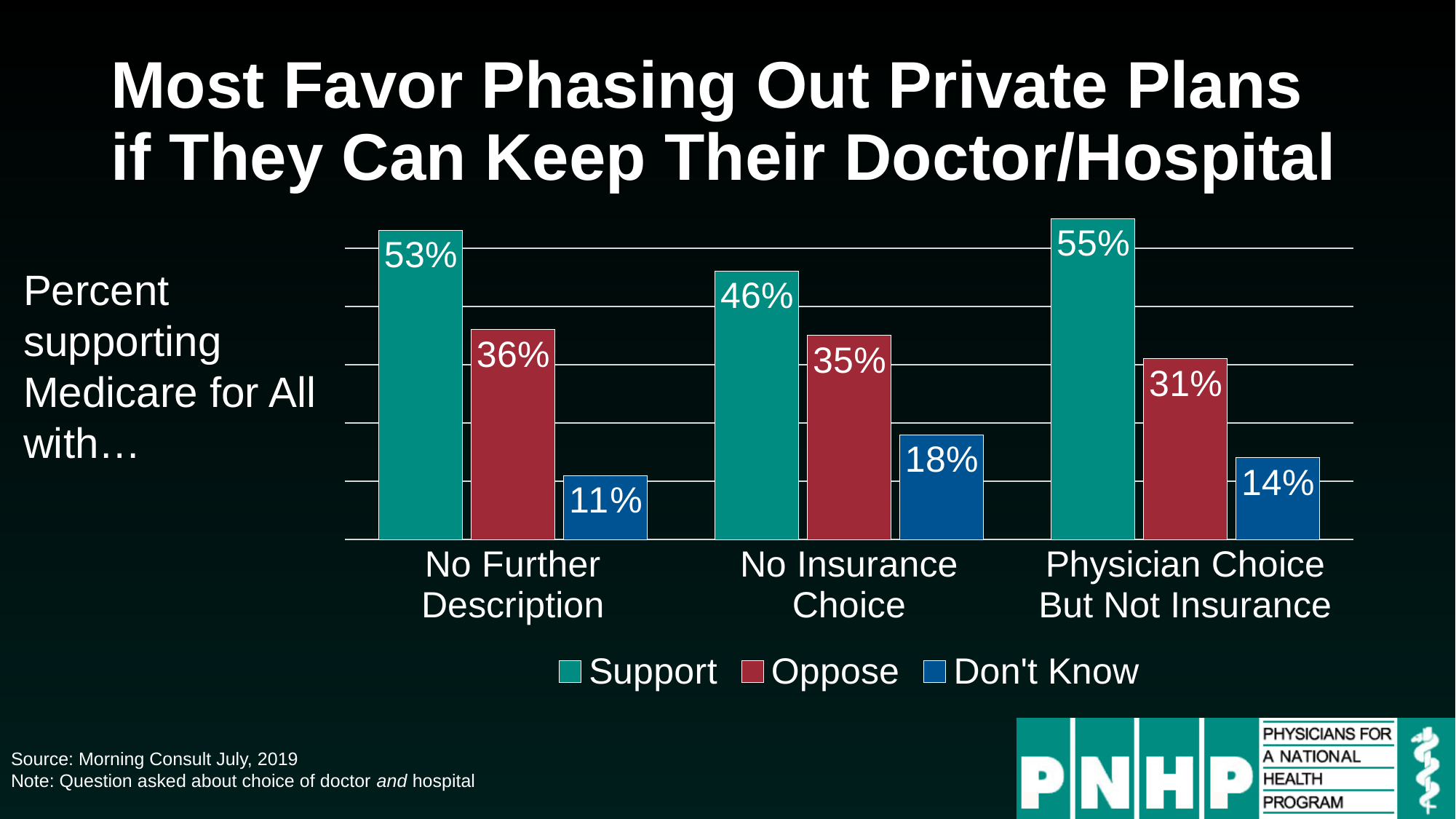
Which series is shown in red in the legend? Oppose Which category has the lowest Don't Know value? No Further Description How many categories are shown on the x axis? 3 What kind of chart is shown on the slide? Bar chart Which category has the highest Support value? Physician Choice But Not Insurance What is the Oppose value for No Insurance Choice? 35% What is the Don't Know value for Physician Choice But Not Insurance? 14% What percent support Medicare for All with No Further Description? 53% How many series does the legend list? 3 What is the difference between the Support and Oppose values for Physician Choice But Not Insurance? 24% What is the difference between the Don't Know values for No Insurance Choice and No Further Description? 7% Which is larger: the Oppose value for No Further Description or the Oppose value for Physician Choice But Not Insurance? No Further Description